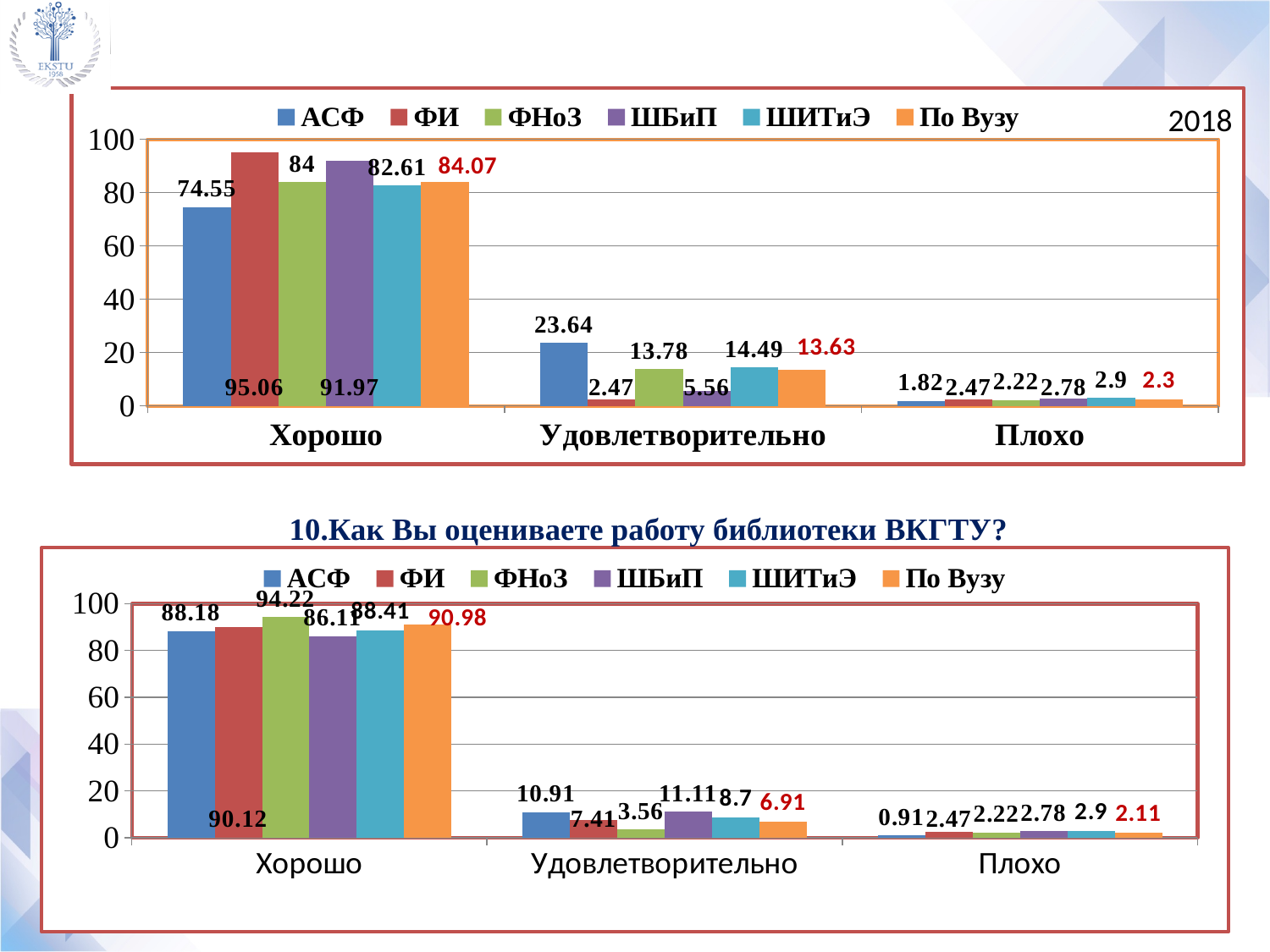
How many categories are shown on the x axis of the bottom chart (10.Как Вы оцениваете работу библиотеки ВКГТУ?)? 3 In the bottom chart (10.Как Вы оцениваете работу библиотеки ВКГТУ?), which series has the highest value in the Удовлетворительно category? ШБиП In the top chart (2018), what is the value for АСФ in the Хорошо category? 74.55 How many series does the legend of the top chart (2018) list? 6 In the top chart (2018), what is the value for По Вузу in the Удовлетворительно category? 13.63 In the bottom chart (10.Как Вы оцениваете работу библиотеки ВКГТУ?), which is larger in the Хорошо category: АСФ or ШБиП? АСФ What kind of chart is the bottom chart (10.Как Вы оцениваете работу библиотеки ВКГТУ?)? Bar chart In the top chart (2018), which series has the highest value in the Хорошо category? ФИ In the bottom chart (10.Как Вы оцениваете работу библиотеки ВКГТУ?), what is the value for По Вузу in the Плохо category? 2.11 In the top chart (2018), what is the difference between the АСФ and ФИ values in the Удовлетворительно category? 21.17 In the top chart (2018), which series has the lowest value in the Плохо category? АСФ In the bottom chart (10.Как Вы оцениваете работу библиотеки ВКГТУ?), what is the value for ФНоЗ in the Хорошо category? 94.22